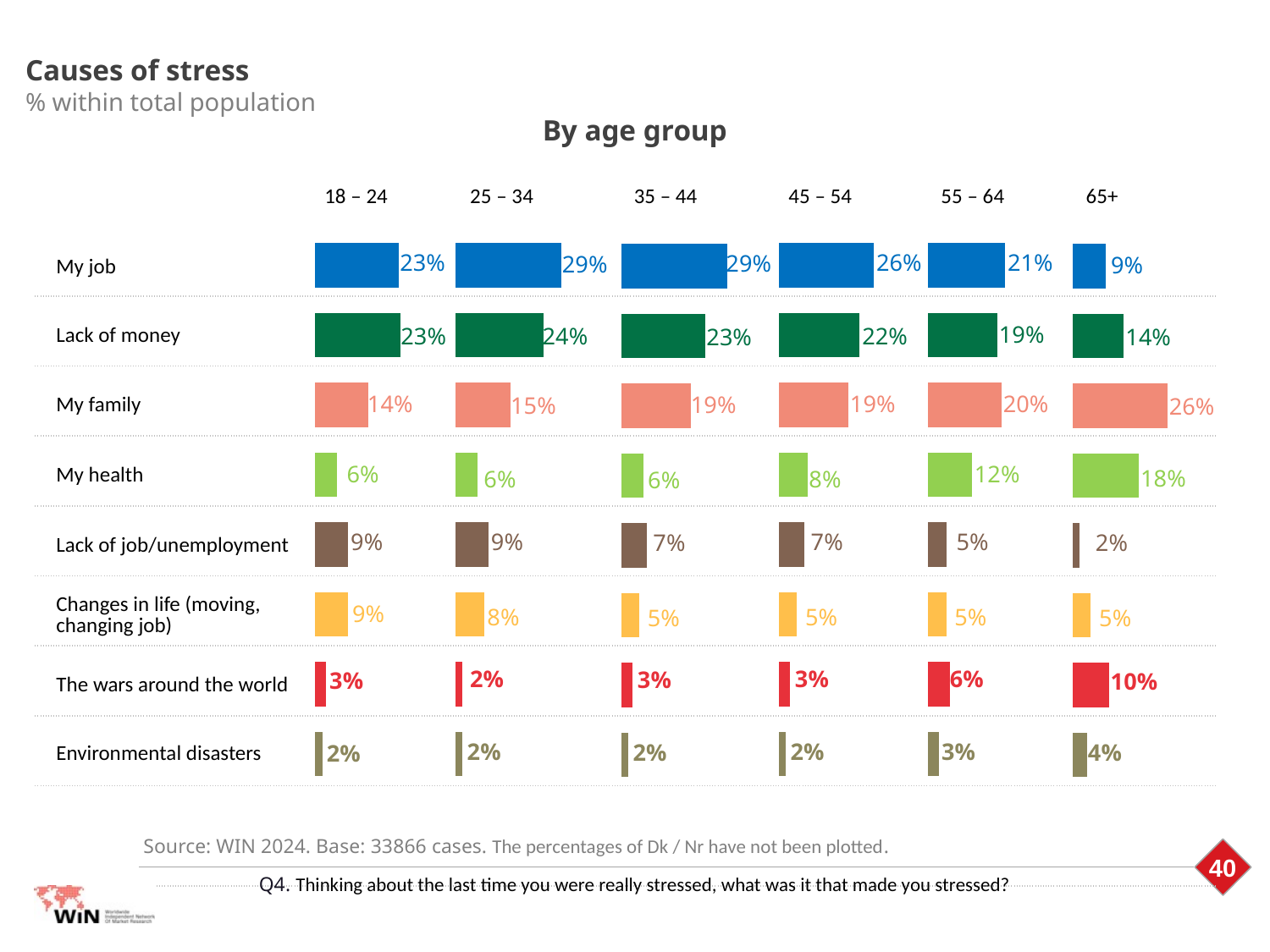
Which age group has the highest value for "My health"? 65+ What is the value for "My family" in the 65+ age group? 26% What kind of chart is used to show the values on this slide? Bar chart How many causes of stress are listed as rows in the chart? 8 What is the difference between the "My job" values for the 25 – 34 and 65+ age groups? 20% What is the title of the chart on this slide? Causes of stress Which age group has the lowest value for "My job"? 65+ Do the values for "Lack of job/unemployment" rise or fall as the age groups get older? Fall What percentage of the 18 – 24 age group cited "My job" as a cause of stress? 23% How many age groups are shown across the chart? 6 What is the value for "The wars around the world" in the 55 – 64 age group? 6% Which is larger for the 45 – 54 age group: "My job" or "Lack of money"? My job